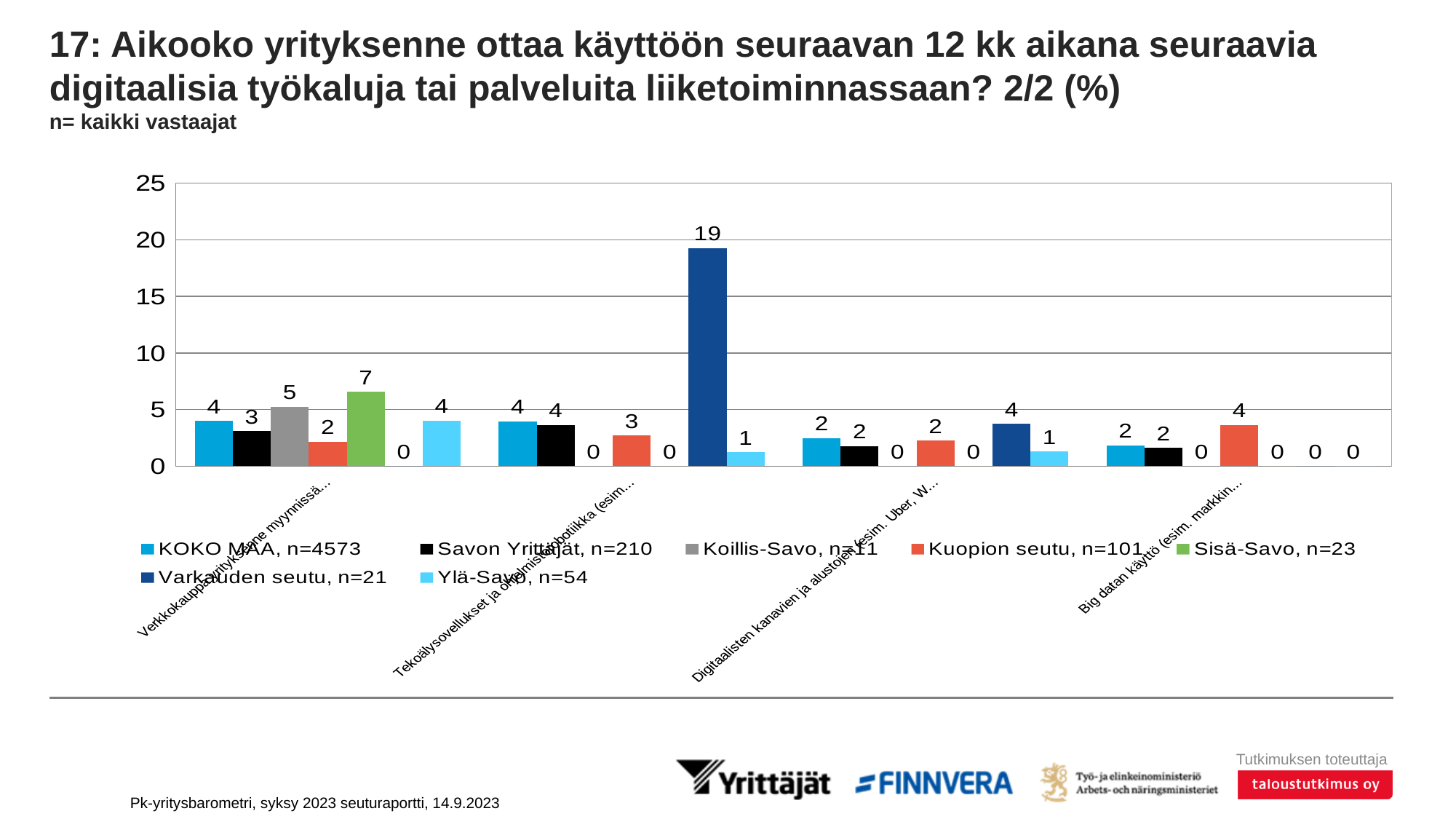
What is the value for KOKO MAA in the 'Digitaalisten kanavien ja alustojen' category? 2 In the 'Verkkokauppa' category, which is larger: Koillis-Savo or Kuopion seutu? Koillis-Savo What is the value for Kuopion seutu in the 'Big datan käyttö' category? 4 What is the difference between Varkauden seutu and Ylä-Savo in the 'Tekoälysovellukset ja ohjelmistorobotiikka' category? 18 Which series has the highest value anywhere in the chart? Varkauden seutu, n=21 How many series does the legend list? 7 How many categories are shown on the x axis? 4 What kind of chart is shown on the slide? bar chart What is the value for Sisä-Savo in the 'Verkkokauppa' category? 7 What is the value for Varkauden seutu in the 'Tekoälysovellukset ja ohjelmistorobotiikka' category? 19 Is the value for Varkauden seutu in the 'Tekoälysovellukset ja ohjelmistorobotiikka' category greater or less than 15? greater What is the sample size (n) given in the legend for KOKO MAA? n=4573